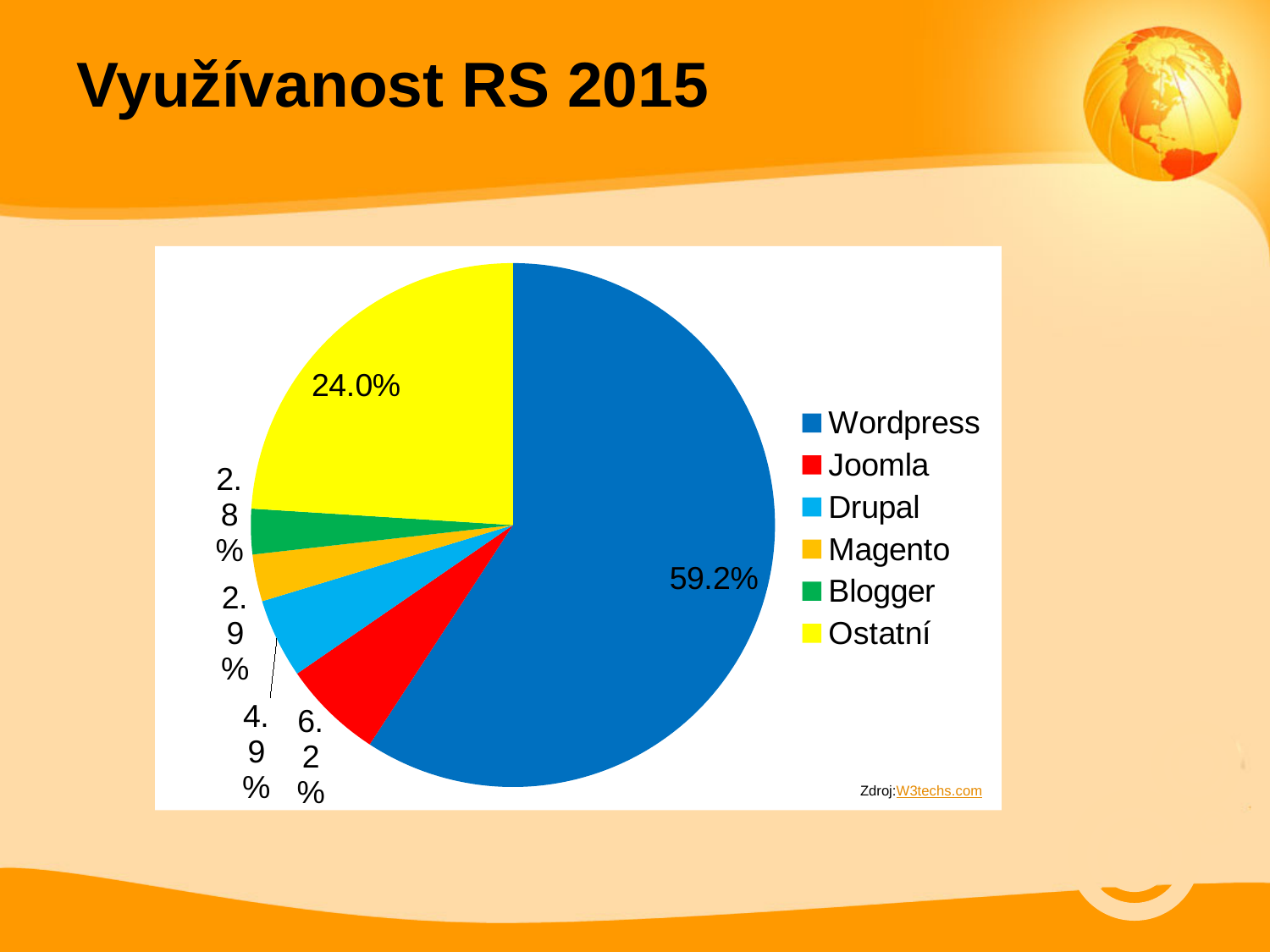
Which category has the largest slice of the pie? Wordpress What is the value shown for Joomla? 6.2% What is the difference between the Wordpress share and the Ostatní share? 35.2% How many entries does the legend list? 6 How many slices does the pie chart have? 6 What is the title of the slide containing the chart? Využívanost RS 2015 Which category has the smallest slice of the pie? Blogger What is the value shown for Drupal? 4.9% Which is larger, the Joomla slice or the Drupal slice? Joomla What share of the pie does Wordpress have? 59.2% What kind of chart is shown on the slide? pie chart What share of the pie does Ostatní have? 24.0%